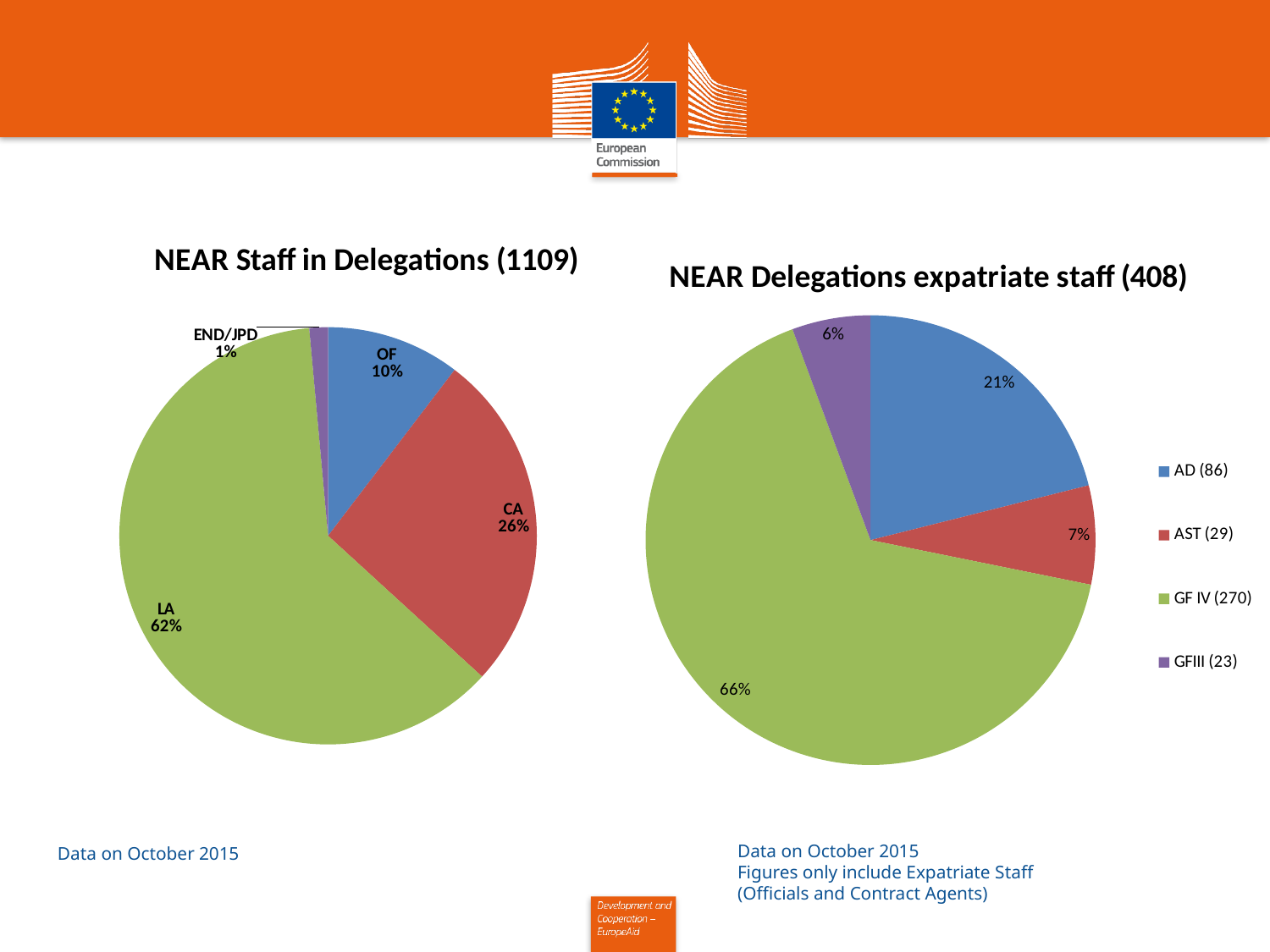
In the 'NEAR Delegations expatriate staff (408)' chart, which is larger, AD or GFIII? AD In the 'NEAR Delegations expatriate staff (408)' chart, what share is AST? 7% In the 'NEAR Staff in Delegations (1109)' chart, which category has the largest share? LA In the 'NEAR Staff in Delegations (1109)' chart, what share of staff is LA? 62% In the 'NEAR Staff in Delegations (1109)' chart, what share of staff is CA? 26% In the 'NEAR Delegations expatriate staff (408)' chart, what number is shown in the legend for GF IV? 270 In the 'NEAR Staff in Delegations (1109)' chart, which category has the smallest share? END/JPD In the 'NEAR Staff in Delegations (1109)' chart, how many categories are shown? 4 What kind of chart is 'NEAR Delegations expatriate staff (408)'? Pie chart In the 'NEAR Staff in Delegations (1109)' chart, what is the difference in percentage points between CA and OF? 16 In the 'NEAR Delegations expatriate staff (408)' chart, how many entries does the legend list? 4